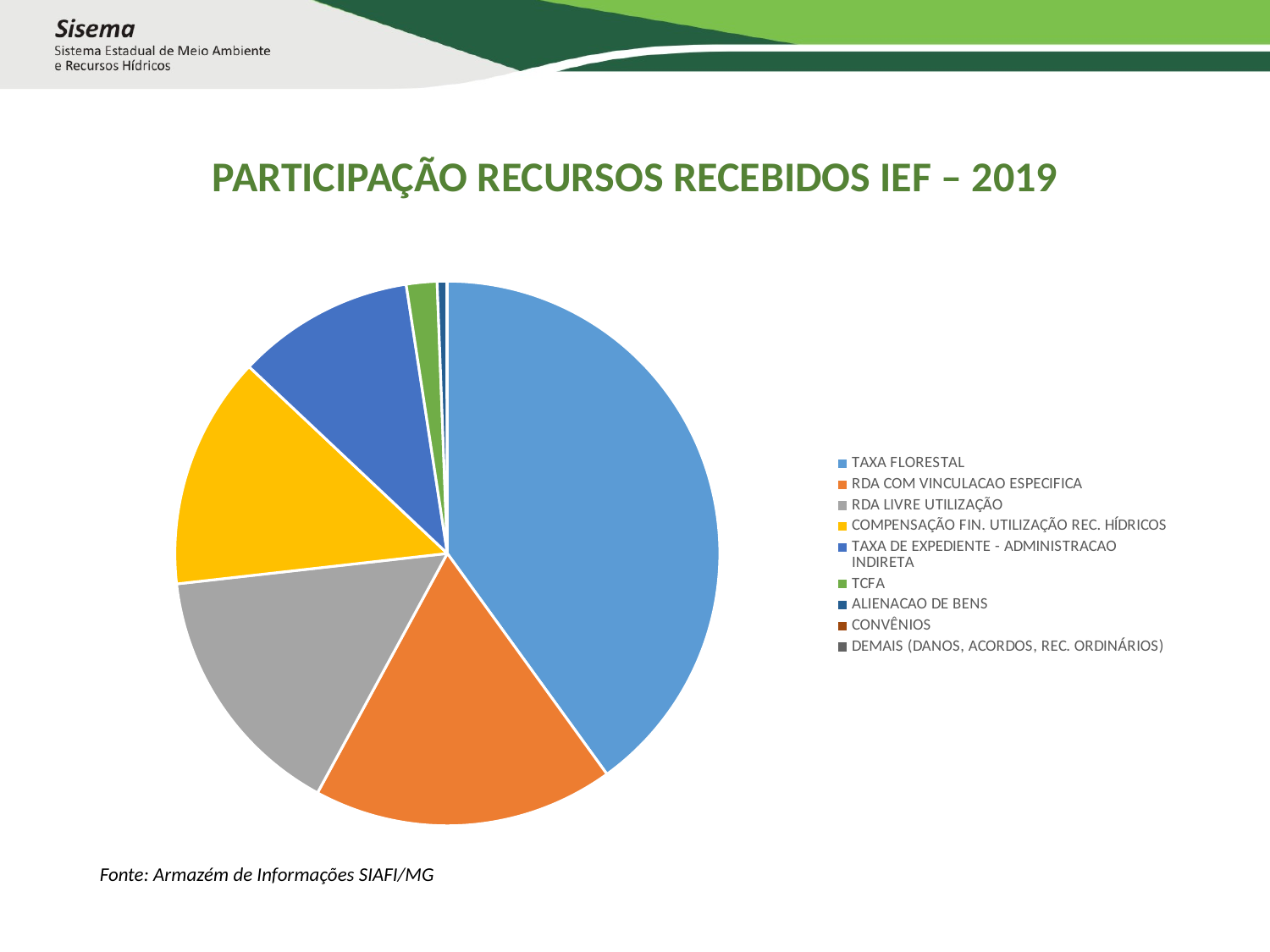
Which category has the largest slice of the pie? TAXA FLORESTAL Which category is shown in yellow in the pie chart? COMPENSAÇÃO FIN. UTILIZAÇÃO REC. HÍDRICOS Which slice is larger: RDA LIVRE UTILIZAÇÃO or TAXA DE EXPEDIENTE - ADMINISTRACAO INDIRETA? RDA LIVRE UTILIZAÇÃO Which slice is larger: TAXA FLORESTAL or RDA COM VINCULACAO ESPECIFICA? TAXA FLORESTAL Which slice is larger: TAXA DE EXPEDIENTE - ADMINISTRACAO INDIRETA or TCFA? TAXA DE EXPEDIENTE - ADMINISTRACAO INDIRETA What kind of chart is shown on the slide? Pie chart Which category is listed last in the legend? DEMAIS (DANOS, ACORDOS, REC. ORDINÁRIOS) What is the title of the chart? PARTICIPAÇÃO RECURSOS RECEBIDOS IEF – 2019 Which category is listed first in the legend? TAXA FLORESTAL How many categories does the legend of the pie chart list? 9